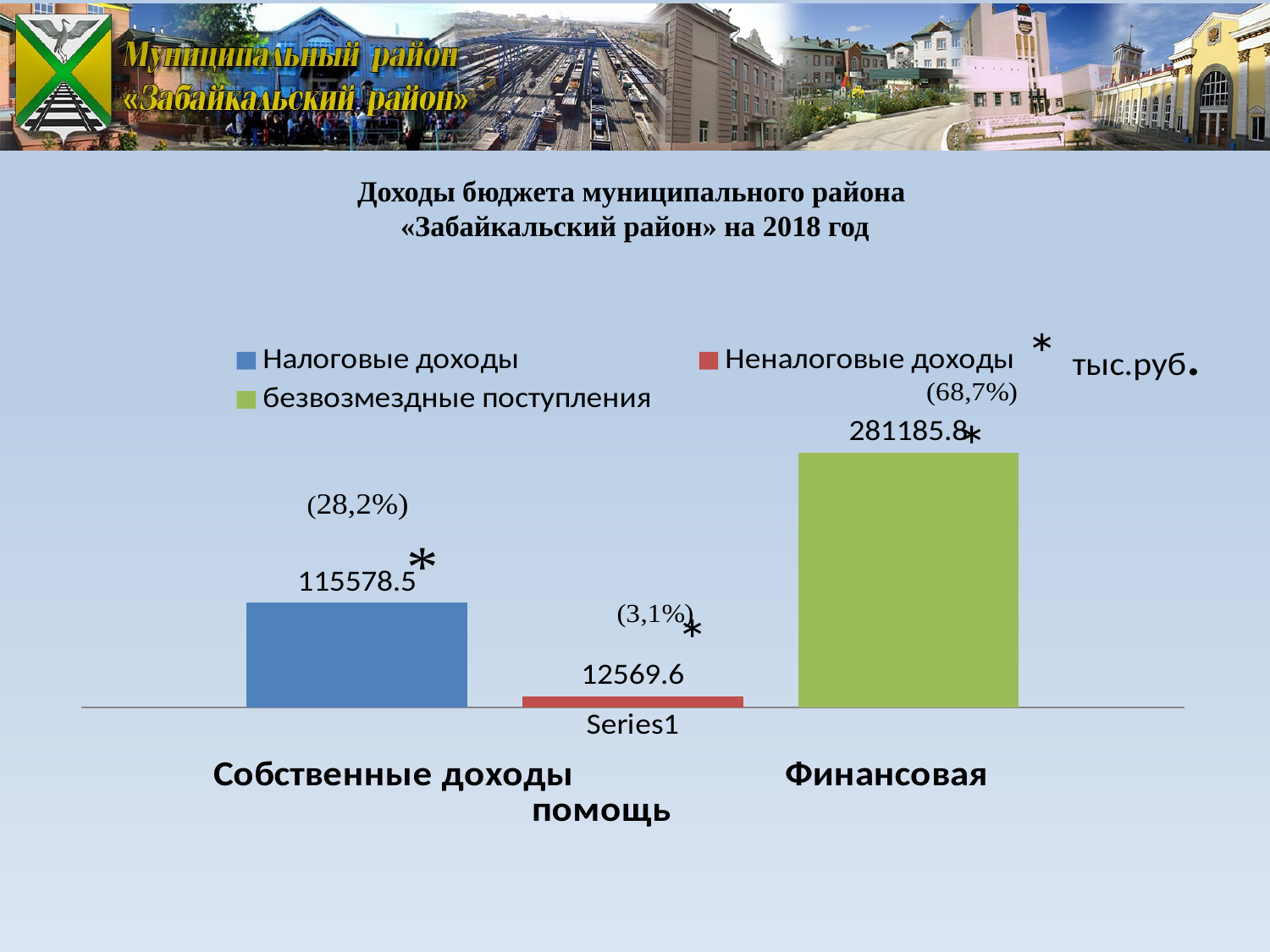
What is the title of the chart? Доходы бюджета муниципального района «Забайкальский район» на 2018 год Which series has the highest value? безвозмездные поступления What is the value for Налоговые доходы? 115578.5 What is the value for Неналоговые доходы? 12569.6 What is the value for безвозмездные поступления? 281185.8 What colour is the bar for безвозмездные поступления? green Which is larger, Налоговые доходы or Неналоговые доходы? Налоговые доходы Which series has the lowest value? Неналоговые доходы How many series does the legend list? 3 What type of chart is shown on the slide? bar chart What is the difference between безвозмездные поступления and Налоговые доходы? 165607.3 What is the difference between Налоговые доходы and Неналоговые доходы? 103008.9